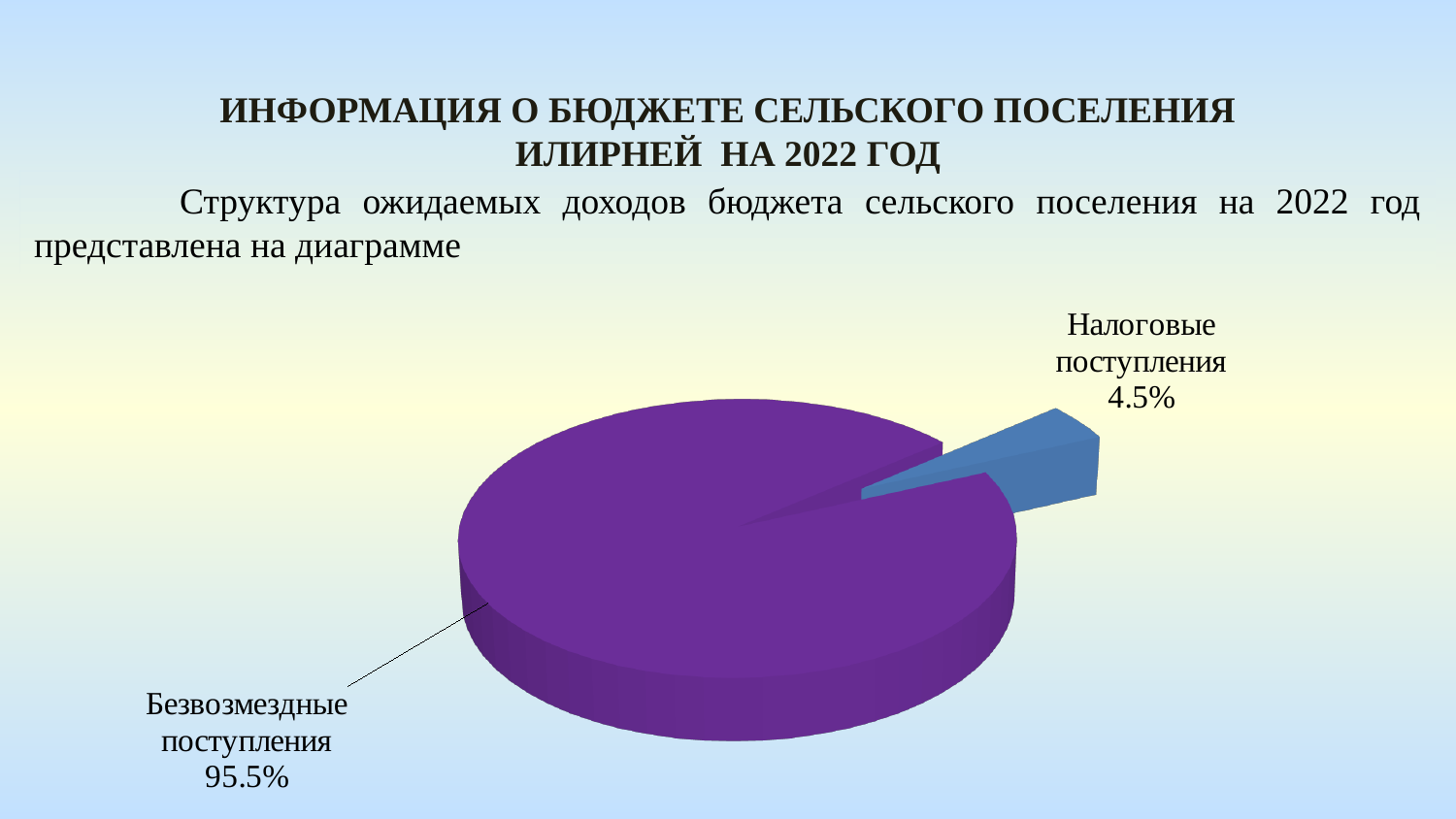
How many slices does the pie chart have? 2 What is the difference in percentage points between "Безвозмездные поступления" and "Налоговые поступления"? 91 percentage points Which category has the smallest share of the pie? Налоговые поступления What colour is the slice for "Безвозмездные поступления"? Purple What share of the pie is labelled "Налоговые поступления"? 4.5% Which is larger: the share for "Налоговые поступления" or the share for "Безвозмездные поступления"? Безвозмездные поступления What kind of chart is shown on the slide? Pie chart What colour is the slice for "Налоговые поступления"? Blue Is the share for "Безвозмездные поступления" greater or less than 90%? greater What share of the pie is labelled "Безвозмездные поступления"? 95.5% Which category has the largest share of the pie? Безвозмездные поступления Is the share for "Налоговые поступления" greater or less than 10%? less